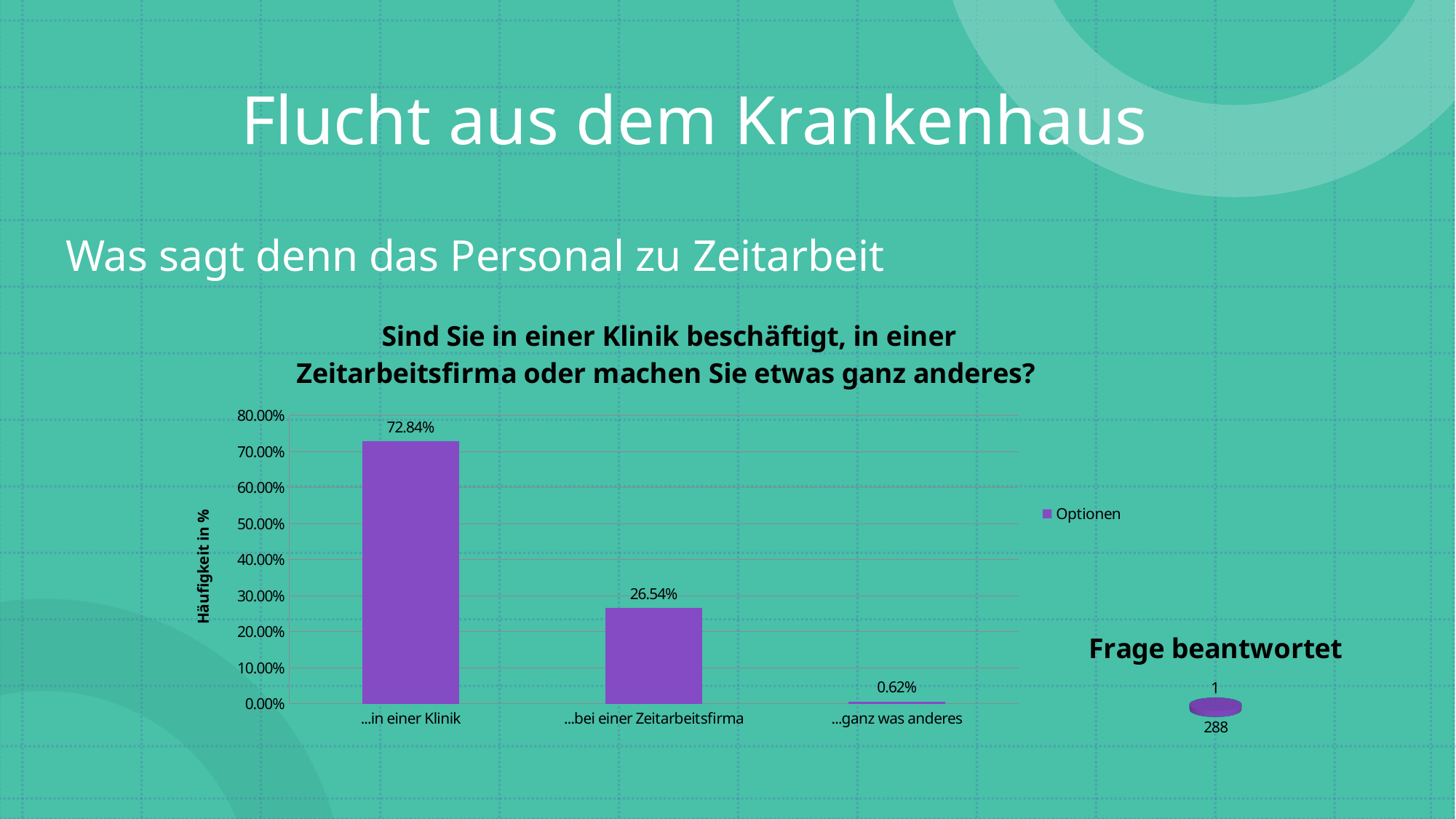
In the bar chart, what is the value for "...in einer Klinik"? 72.84% How many series does the legend of the bar chart list? 1 In the bar chart, which is larger: the value for "...bei einer Zeitarbeitsfirma" or for "...ganz was anderes"? ...bei einer Zeitarbeitsfirma In the bar chart, is the value for "...in einer Klinik" greater or less than 70.00%? greater In the bar chart, which category has the highest value? ...in einer Klinik In the bar chart, which category has the lowest value? ...ganz was anderes In the bar chart, what is the value for "...bei einer Zeitarbeitsfirma"? 26.54% In the bar chart, what is the value for "...ganz was anderes"? 0.62% How many categories does the bar chart show? 3 In the bar chart, what is the difference between the values for "...in einer Klinik" and "...bei einer Zeitarbeitsfirma"? 46.30% What kind of chart is the chart titled "Sind Sie in einer Klinik beschäftigt, in einer Zeitarbeitsfirma oder machen Sie etwas ganz anderes?"? bar chart